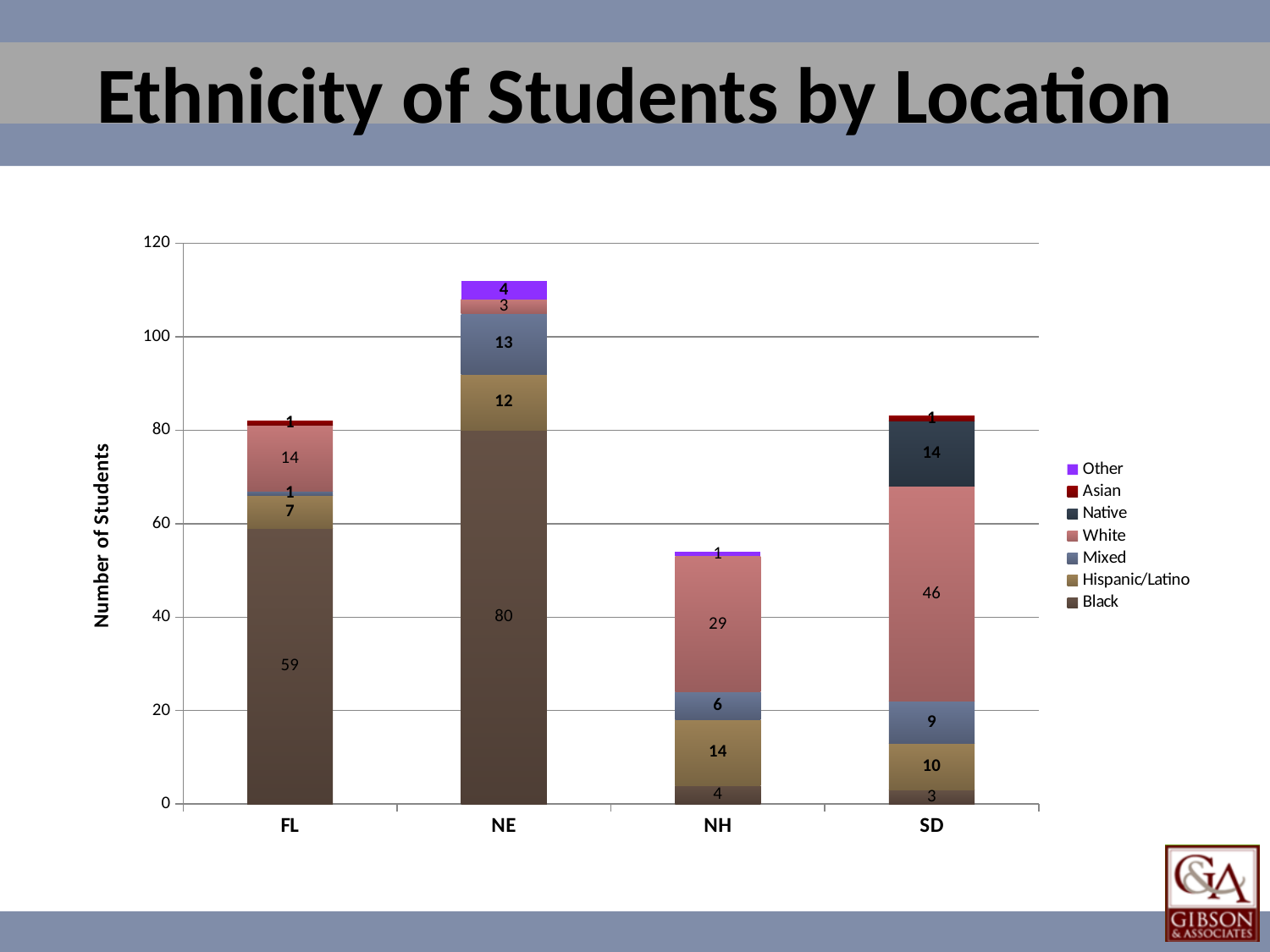
What is the total number of students at NE? 112 What kind of chart is shown on the slide? Stacked bar chart Which location has the highest total number of students? NE Which location has the lowest total number of students? NH How many White students are there at SD? 46 How many Black students are there at NE? 80 How many Hispanic/Latino students are there at NH? 14 What is the title of the y axis? Number of Students How many series does the legend list? 7 Which location has more White students, NH or SD? SD What is the difference between the number of Black students at NE and at FL? 21 How many locations are shown on the x axis? 4